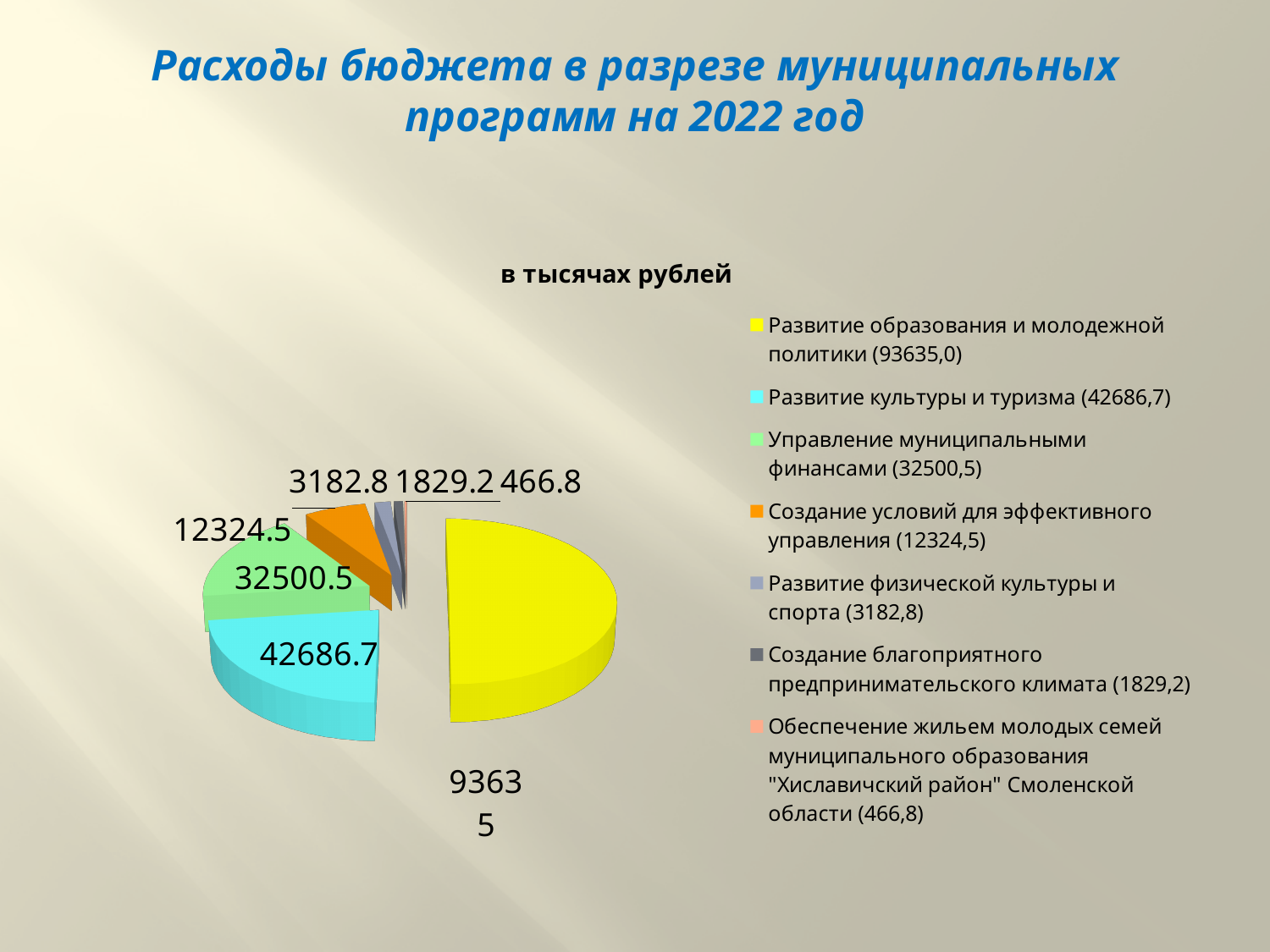
What is the difference between the values for Развитие культуры и туризма and Управление муниципальными финансами? 10186.2 What is the value for Создание условий для эффективного управления? 12324.5 In what units are the values on the chart expressed, according to the chart title? в тысячах рублей How many slices (categories) does the pie chart have? 7 What colour is the slice for Развитие образования и молодежной политики? yellow What is the value for Управление муниципальными финансами? 32500.5 What is the value for Развитие культуры и туризма? 42686.7 What is the value for Развитие физической культуры и спорта? 3182.8 Which is larger: the value for Развитие физической культуры и спорта or for Создание благоприятного предпринимательского климата? Развитие физической культуры и спорта Which category has the largest slice of the pie? Развитие образования и молодежной политики Which category has the smallest slice of the pie? Обеспечение жильем молодых семей муниципального образования "Хиславичский район" Смоленской области What kind of chart is shown on the slide? pie chart